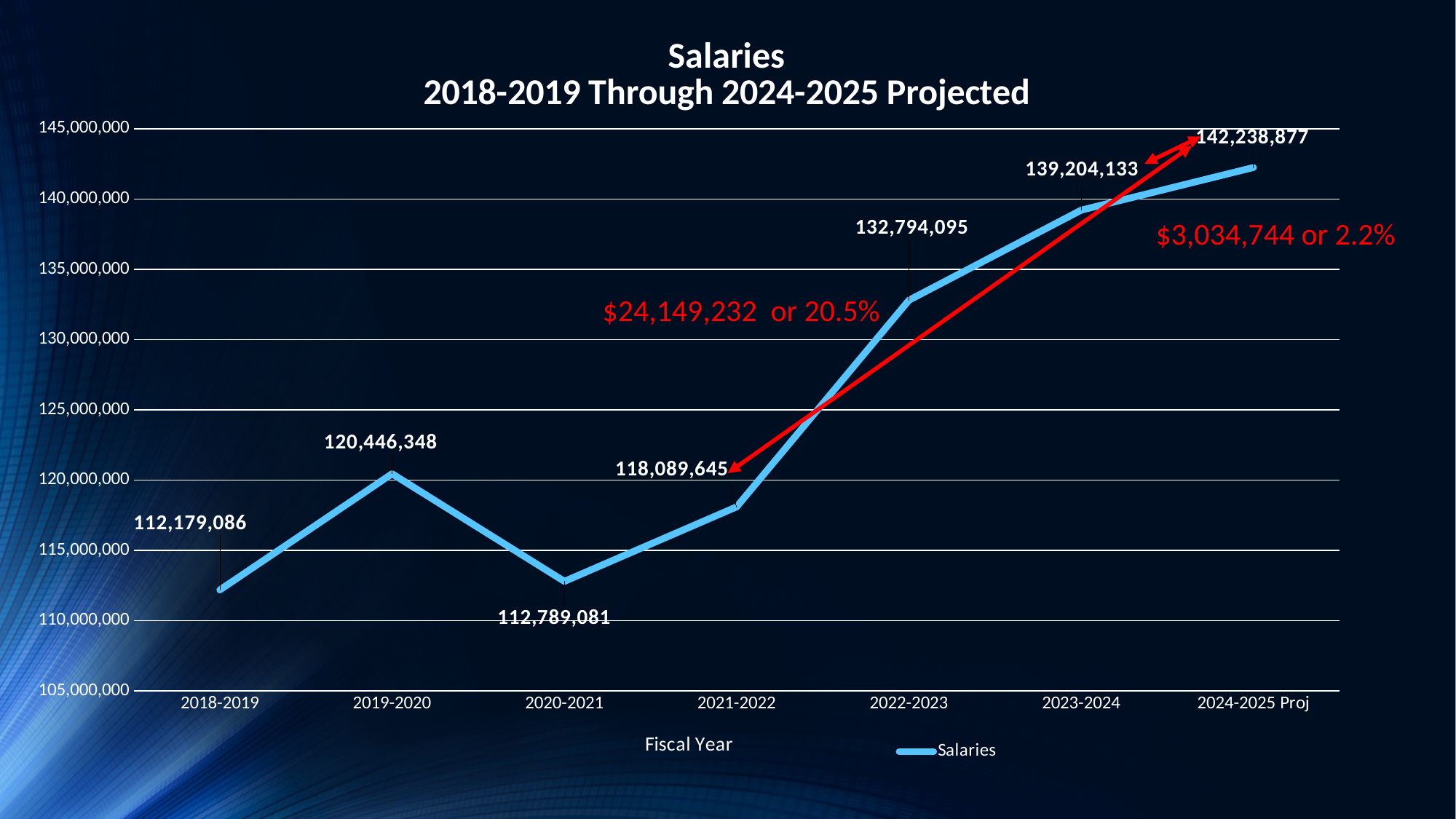
What is the difference between the salaries for 2019-2020 and 2018-2019? 8,267,262 Is the salaries value for 2023-2024 greater or less than 140,000,000? less What is the projected salaries value for 2024-2025? 142,238,877 Which fiscal year has the highest salaries value? 2024-2025 Proj What is the salaries value for 2022-2023? 132,794,095 Which fiscal year has the lowest salaries value? 2018-2019 Which is larger, the salaries value for 2019-2020 or for 2021-2022? 2019-2020 Do the salaries rise or fall from 2019-2020 to 2020-2021? fall What is the salaries value for 2019-2020? 120,446,348 How many fiscal years are plotted on the chart? 7 What kind of chart is shown on the slide? line chart What is the difference between the salaries for 2024-2025 Proj and 2023-2024? 3,034,744